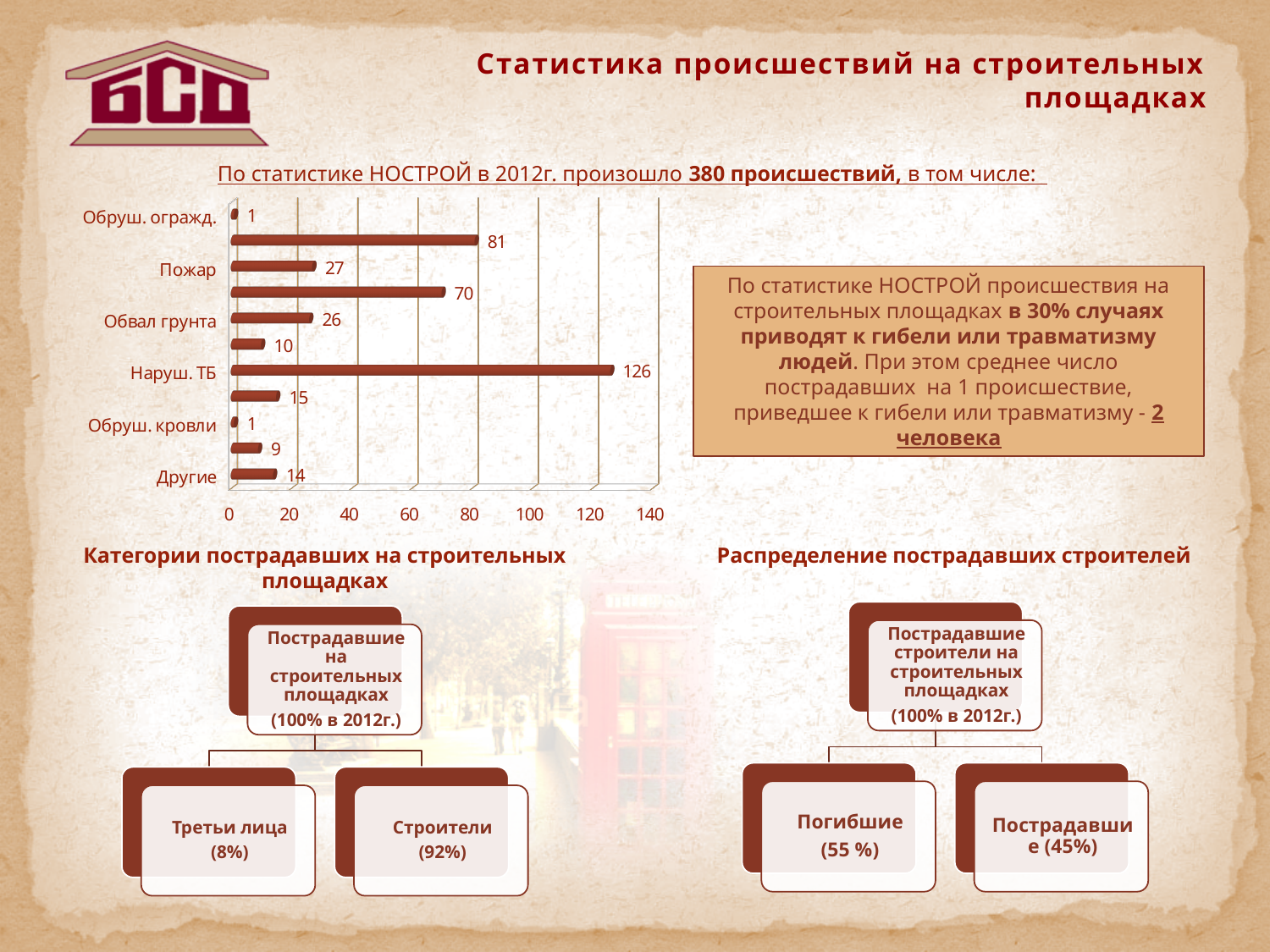
How many bars are plotted in the chart? 11 Which category has the highest value? Наруш. ТБ What is the difference between the values for Наруш. ТБ and Другие? 112 What is the value for Другие? 14 What is the value for Обвал грунта? 26 Is the value for Наруш. ТБ greater or less than 100? greater What is the value for Пожар? 27 What is the value for Обруш. кровли? 1 Which is larger, the value for Пожар or the value for Другие? Пожар What type of chart is shown on the slide? bar chart What is the difference between the values for Пожар and Обвал грунта? 1 What is the value for Наруш. ТБ? 126